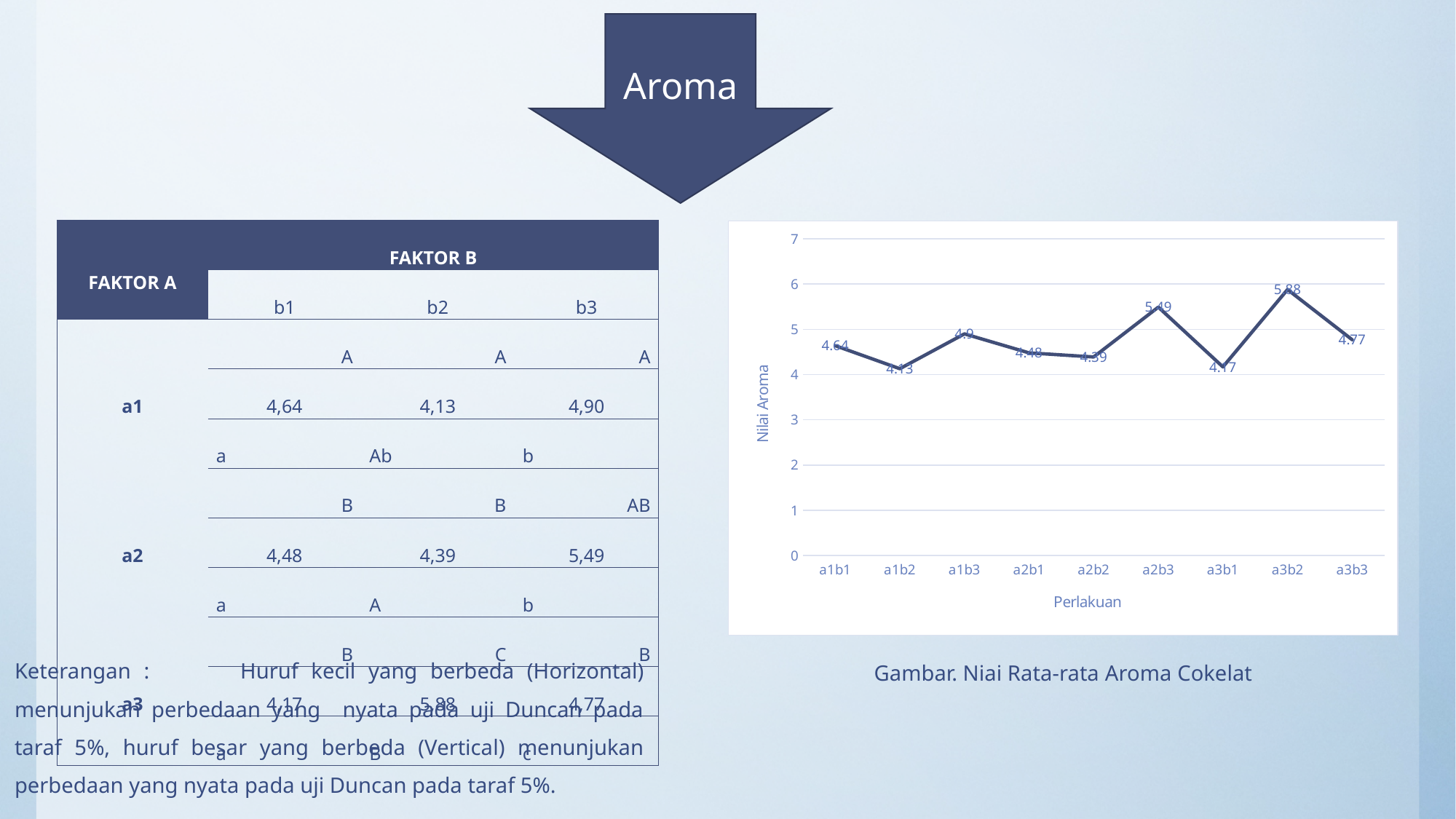
How many treatments (categories) are plotted on the x axis? 9 Does the value rise or fall from a1b1 to a1b2? fall What is the difference between the values for a3b2 and a1b1? 1.24 What is the value for a3b3 in the chart? 4.77 What is the value for a2b3 in the chart? 5.49 Which is larger, the value for a2b3 or the value for a1b3? a2b3 Is the value for a3b2 greater or less than 5? greater Which treatment (perlakuan) has the highest Nilai Aroma? a3b2 What is the title of the vertical axis of the chart? Nilai Aroma What is the value for a1b1 in the chart? 4.64 What type of chart is shown on the slide? line chart Which treatment (perlakuan) has the lowest Nilai Aroma? a1b2